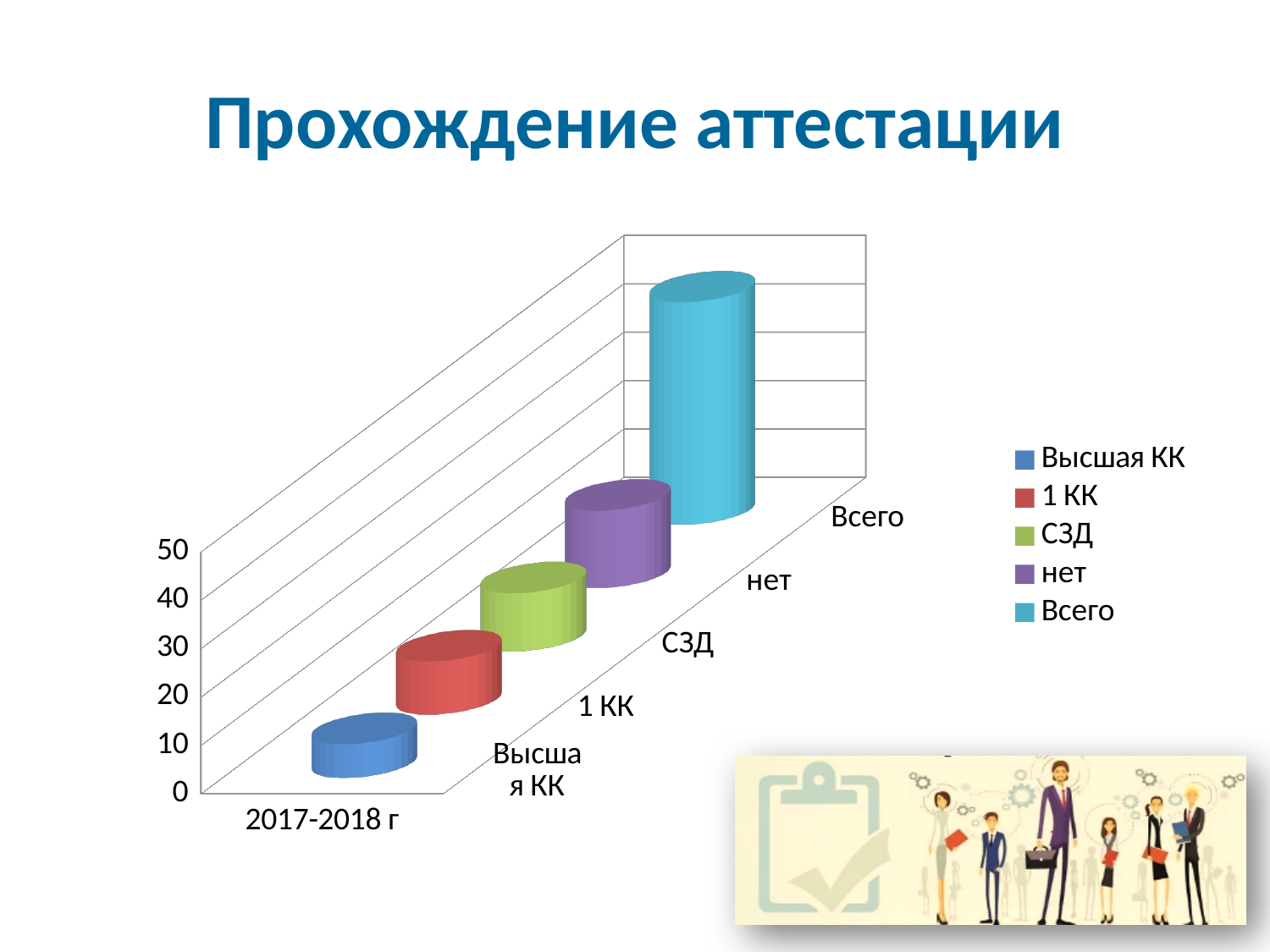
Which is larger, the value for Всего or the value for нет? Всего Which is larger, the value for нет or the value for 1 КК? нет Which series has the lowest value? Высшая КК What kind of chart is shown on the slide? bar chart What is the highest value shown on the vertical axis? 50 What is the title of the chart? Прохождение аттестации Is the value for Высшая КК greater or less than 20? less How many series does the legend list? 5 Is the value for Всего greater or less than 30? greater What period is labelled on the horizontal axis of the chart? 2017-2018 г Which series has the highest value? Всего